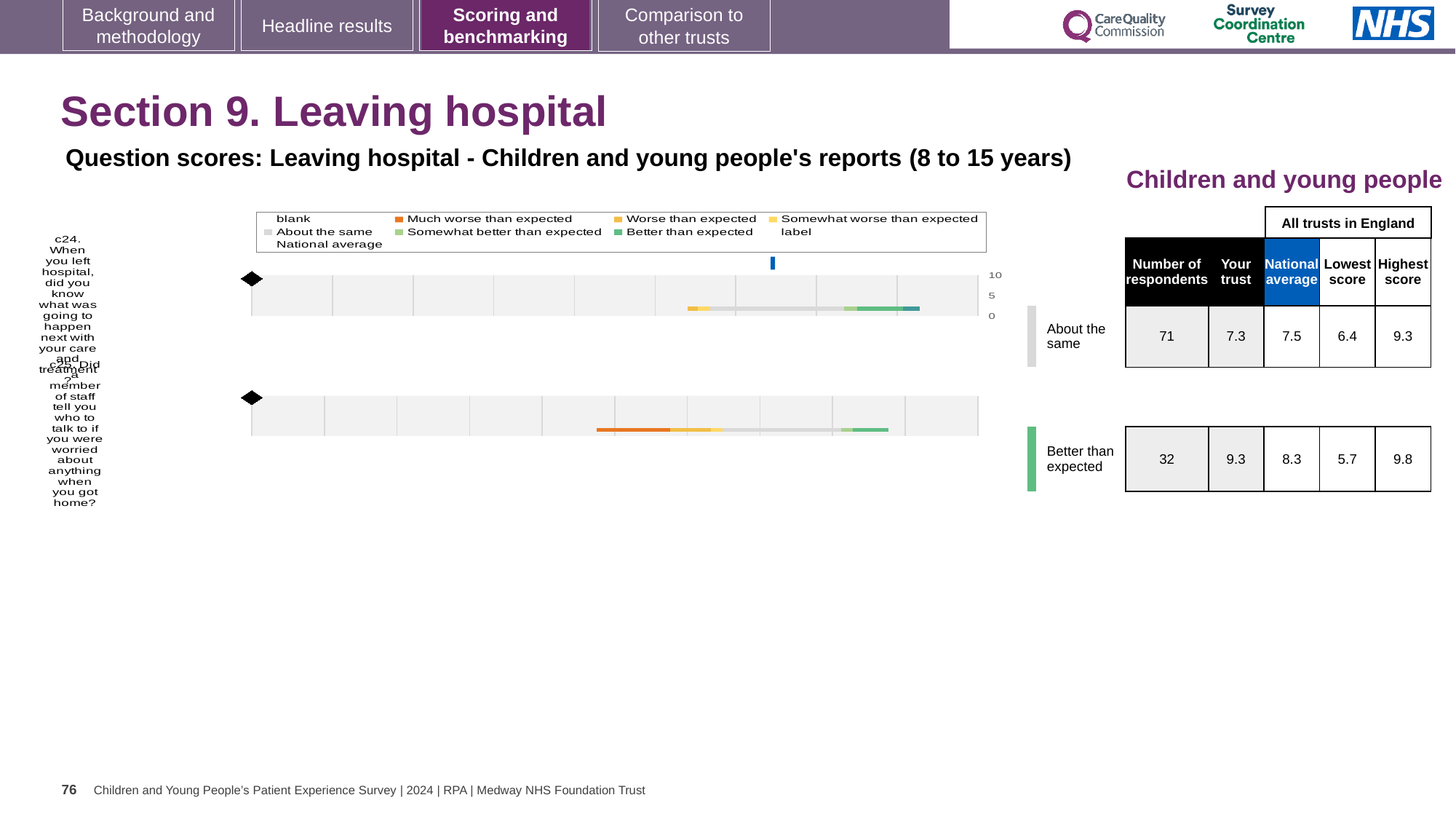
Which question has the higher 'Your trust' score in the table beside the chart, c24 or c25? c25 According to the table beside the chart, what is the national average for question c24? 7.5 How many entries does the chart legend list? 9 What is the difference between the 'Your trust' score and the national average for question c25 in the table beside the chart? 1.0 What kind of chart is shown on the slide? Bar chart According to the table beside the chart, how many respondents answered question c25? 32 According to the table beside the chart, what is the 'Your trust' score for question c25? 9.3 What benchmark category is shown next to the chart for question c25? Better than expected What colour does the legend use for 'Much worse than expected'? Orange What is the title of the chart? Question scores: Leaving hospital - Children and young people's reports (8 to 15 years) How many questions (categories) are plotted in the chart? 2 According to the table beside the chart, what is the 'Your trust' score for question c24? 7.3